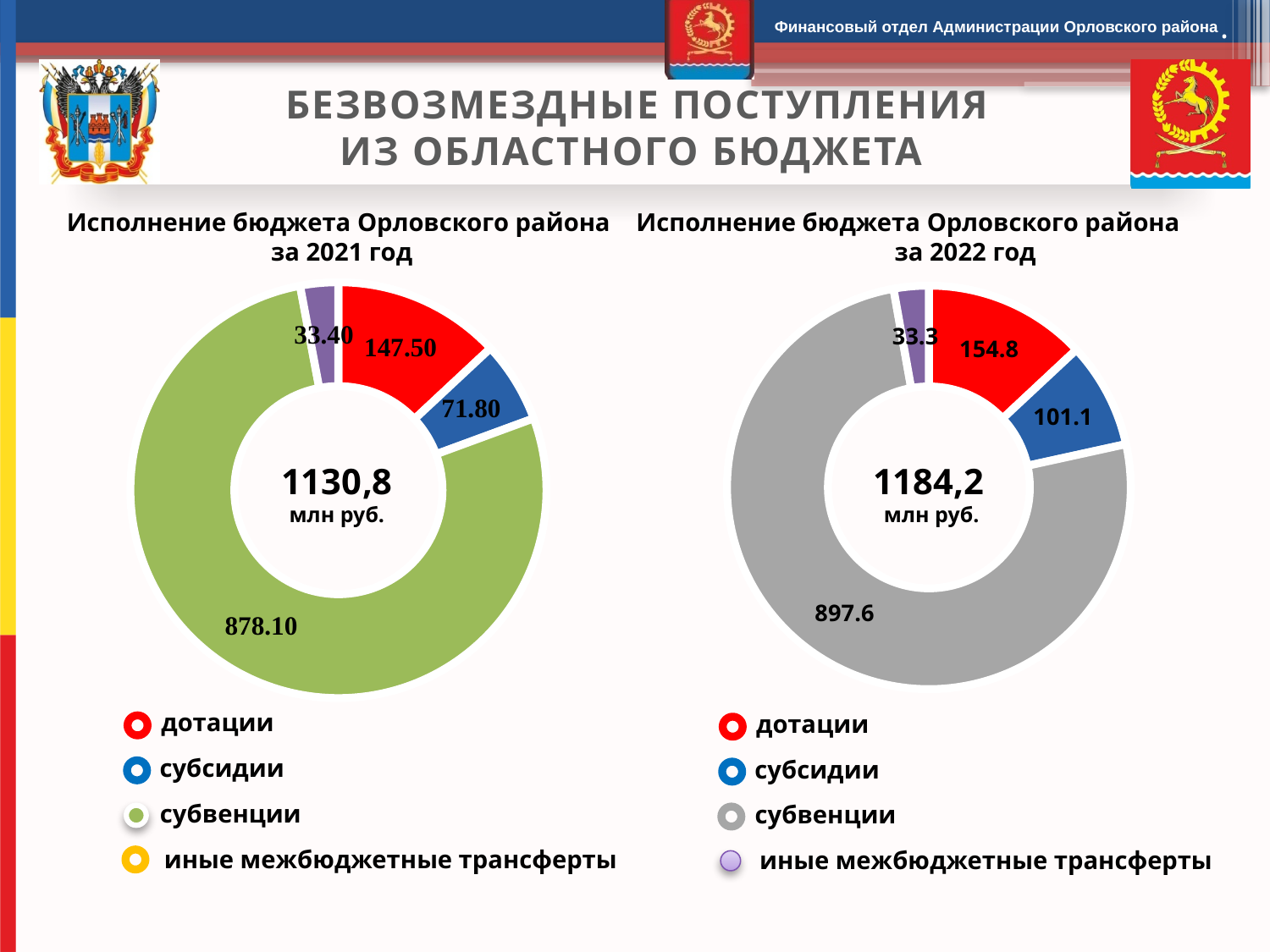
What total is shown in the centre of the chart 'Исполнение бюджета Орловского района за 2022 год'? 1184,2 млн руб. What is the difference between the субвенции value in the 2022 chart and the субвенции value in the 2021 chart? 19.5 In the chart 'Исполнение бюджета Орловского района за 2022 год', what is the value for субсидии? 101.1 In the chart 'Исполнение бюджета Орловского района за 2022 год', what is the value for иные межбюджетные трансферты? 33.3 What kind of chart is 'Исполнение бюджета Орловского района за 2021 год'? Donut (pie) chart In the chart 'Исполнение бюджета Орловского района за 2022 год', which category has the largest slice? субвенции In the chart 'Исполнение бюджета Орловского района за 2021 год', what is the value for субвенции? 878.10 In the chart 'Исполнение бюджета Орловского района за 2021 год', what is the difference between дотации and субсидии? 75.70 Which is larger: дотации in the 2021 chart or дотации in the 2022 chart? дотации in the 2022 chart How many categories does the chart 'Исполнение бюджета Орловского района за 2021 год' show? 4 In the chart 'Исполнение бюджета Орловского района за 2021 год', which category has the smallest slice? иные межбюджетные трансферты In the chart 'Исполнение бюджета Орловского района за 2021 год', what is the value for дотации? 147.50